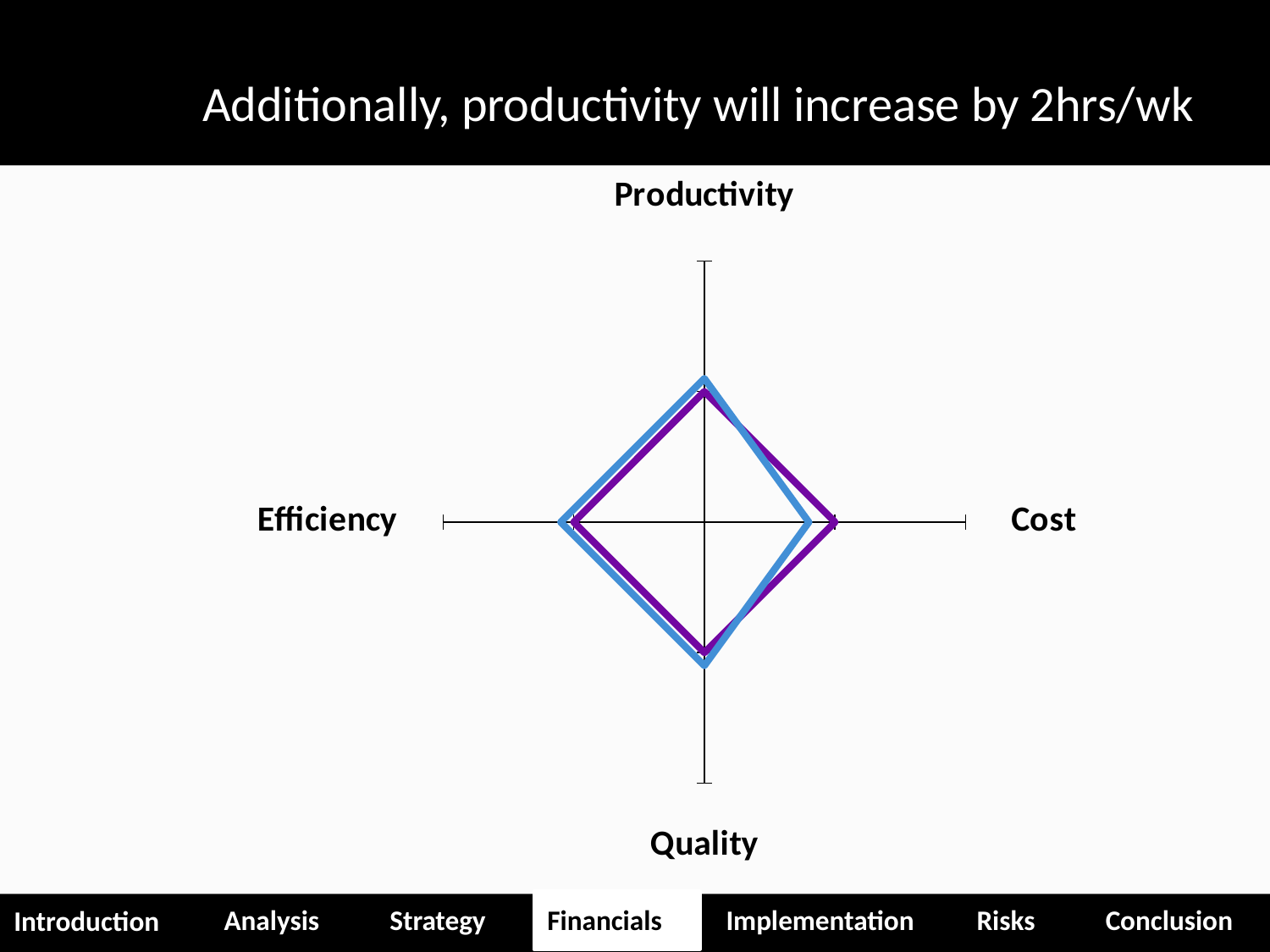
Which category label appears at the bottom of the radar chart? Quality Which category is on the left-hand axis of the radar chart? Efficiency Which category is on the right-hand axis of the radar chart? Cost How many data series are plotted on the radar chart? 2 How many categories (axes) does the radar chart have? 4 What kind of chart is shown on the slide? Radar chart On the Cost axis, which series extends further from the centre, the blue one or the purple one? Purple